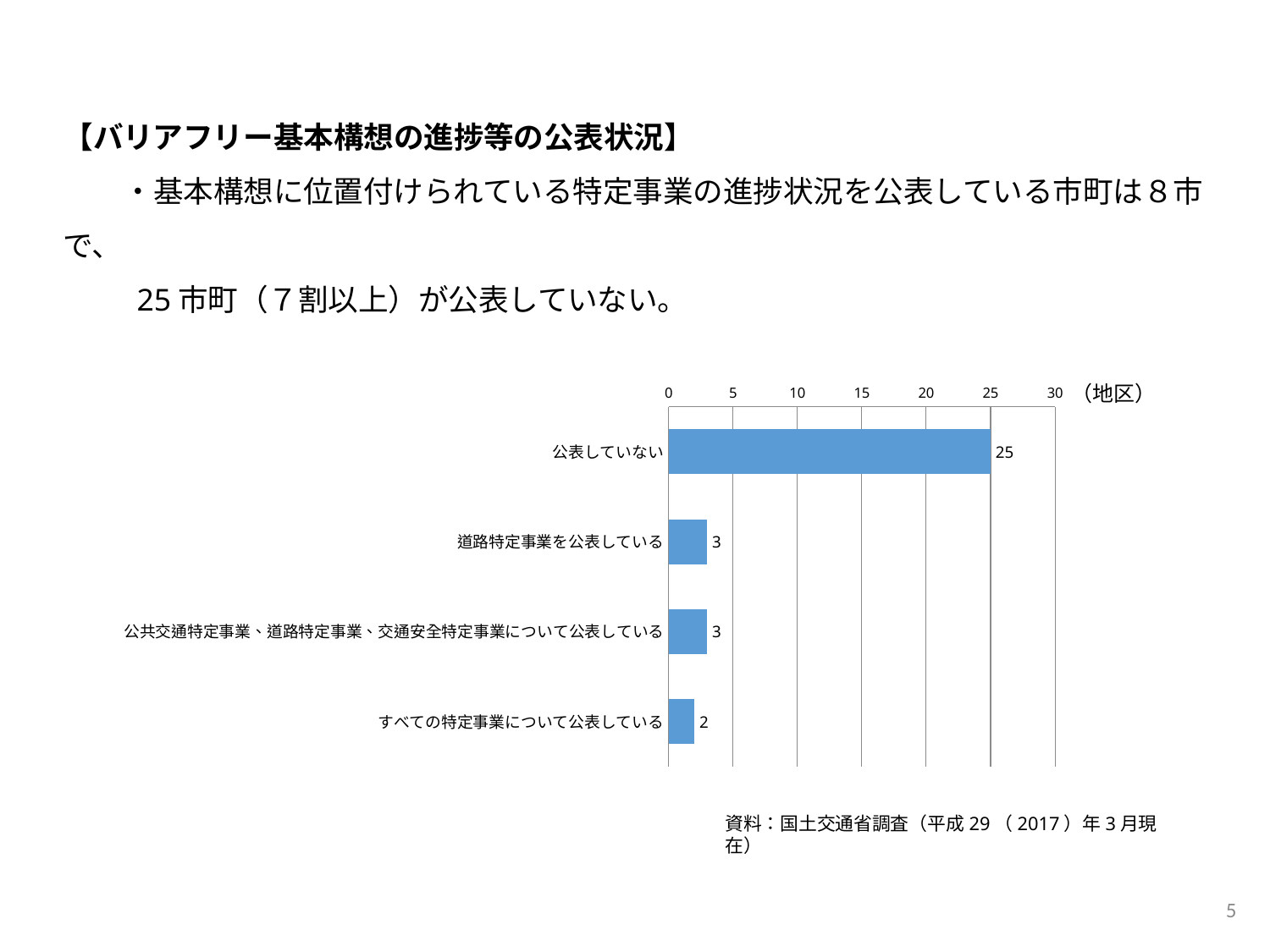
What unit label is shown at the end of the value axis? （地区） What is the value for 公表していない? 25 What is the difference between the values for 公表していない and 道路特定事業を公表している? 22 What is the value for 公共交通特定事業、道路特定事業、交通安全特定事業について公表している? 3 What is the value for すべての特定事業について公表している? 2 Which category has the highest value? 公表していない Which is larger, the value for 道路特定事業を公表している or the value for すべての特定事業について公表している? 道路特定事業を公表している How many categories are shown in the chart? 4 What kind of chart is shown on the slide? bar chart What is the value for 道路特定事業を公表している? 3 Is the value for 公表していない greater or less than 20? greater Which category has the lowest value? すべての特定事業について公表している